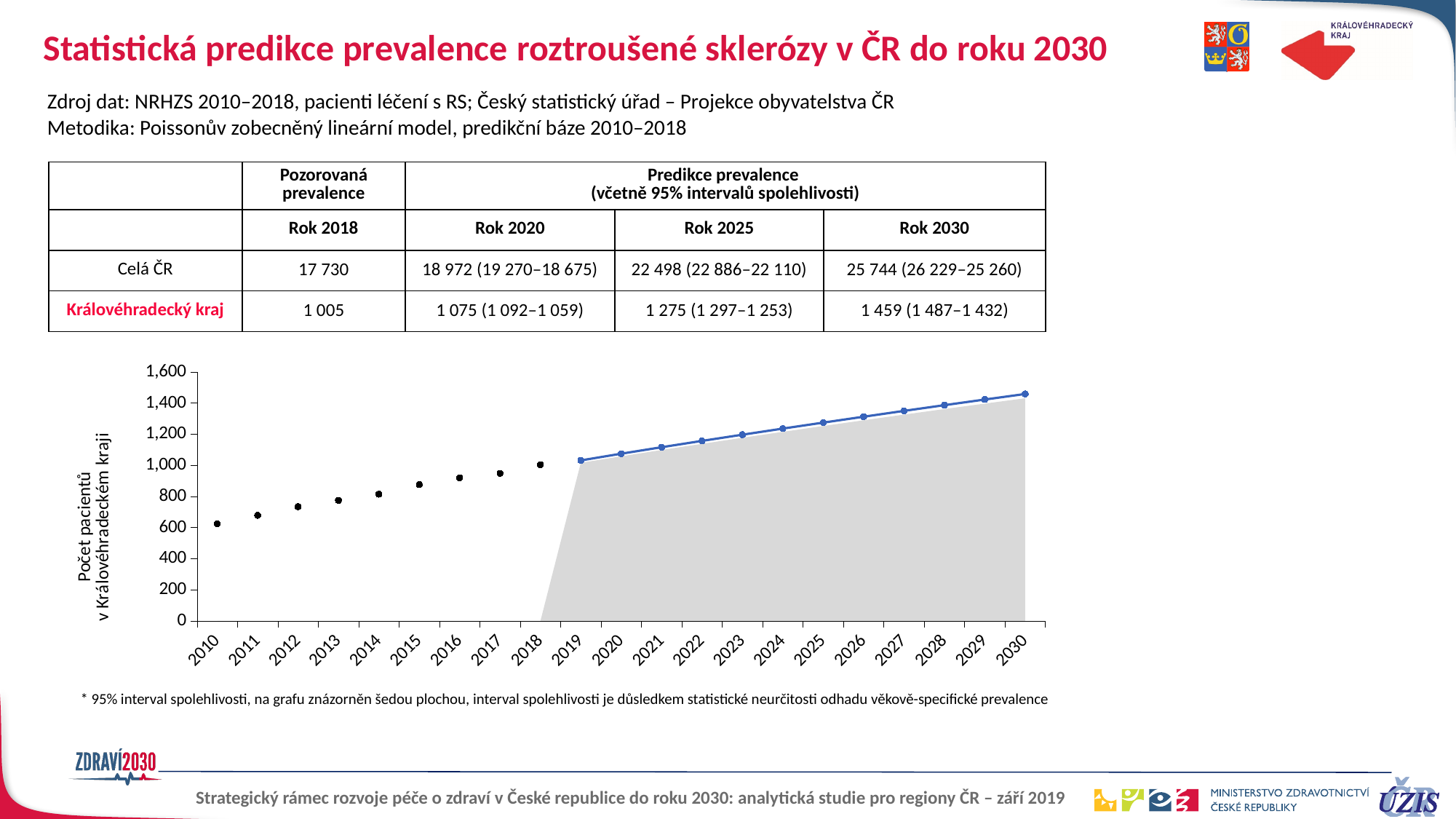
Is the value for 2025 greater or less than 1,200? greater How many years are shown on the x axis of the chart? 21 What kind of chart is shown on the slide? line chart Is the value for 2015 greater or less than 1,000? less Which year has the highest value in the chart? 2030 Is the value for 2010 greater or less than 800? less Which year has the larger value, 2013 or 2027? 2027 What is the label of the y axis of the chart? Počet pacientů v Královéhradeckém kraji Which year has the lowest value in the chart? 2010 Do the values in the chart rise or fall from 2010 to 2030? rise What does the grey area in the chart represent? 95% interval spolehlivosti